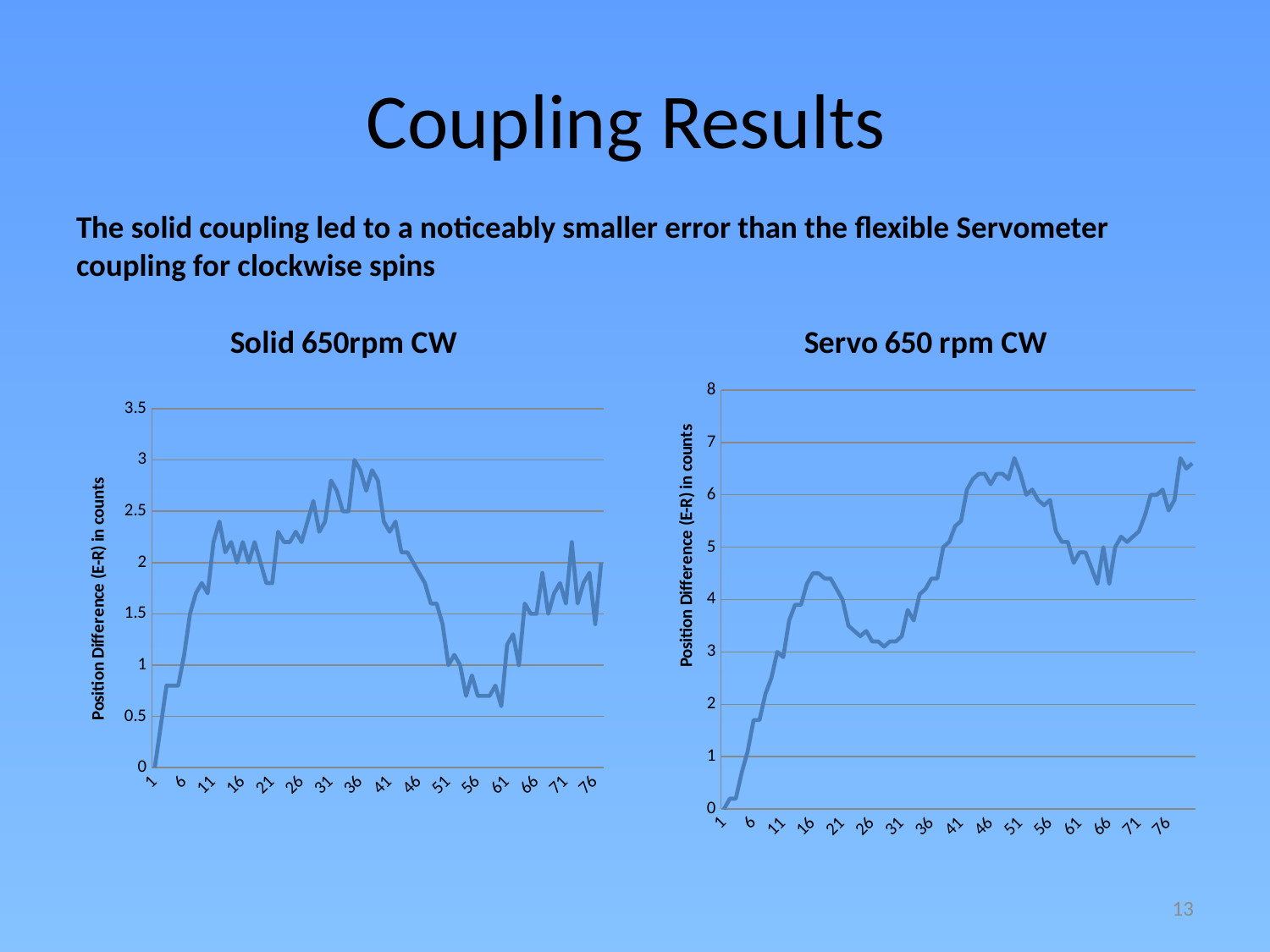
What kind of chart is the "Servo 650 rpm CW" chart? line chart In the "Solid 650rpm CW" chart, is the value at x = 56 greater or less than 1? less In the "Servo 650 rpm CW" chart, is the value at x = 51 greater or less than 6? greater What kind of chart is the "Solid 650rpm CW" chart? line chart In the "Solid 650rpm CW" chart, is the value at x = 11 greater or less than 2? greater How many charts are shown on the slide? 2 In the "Servo 650 rpm CW" chart, do the values rise or fall between x = 1 and x = 16? rise In the "Solid 650rpm CW" chart, do the values rise or fall between x = 36 and x = 56? fall What is the y-axis label of the "Servo 650 rpm CW" chart? Position Difference (E-R) in counts What is the highest y-axis tick value on the "Solid 650rpm CW" chart? 3.5